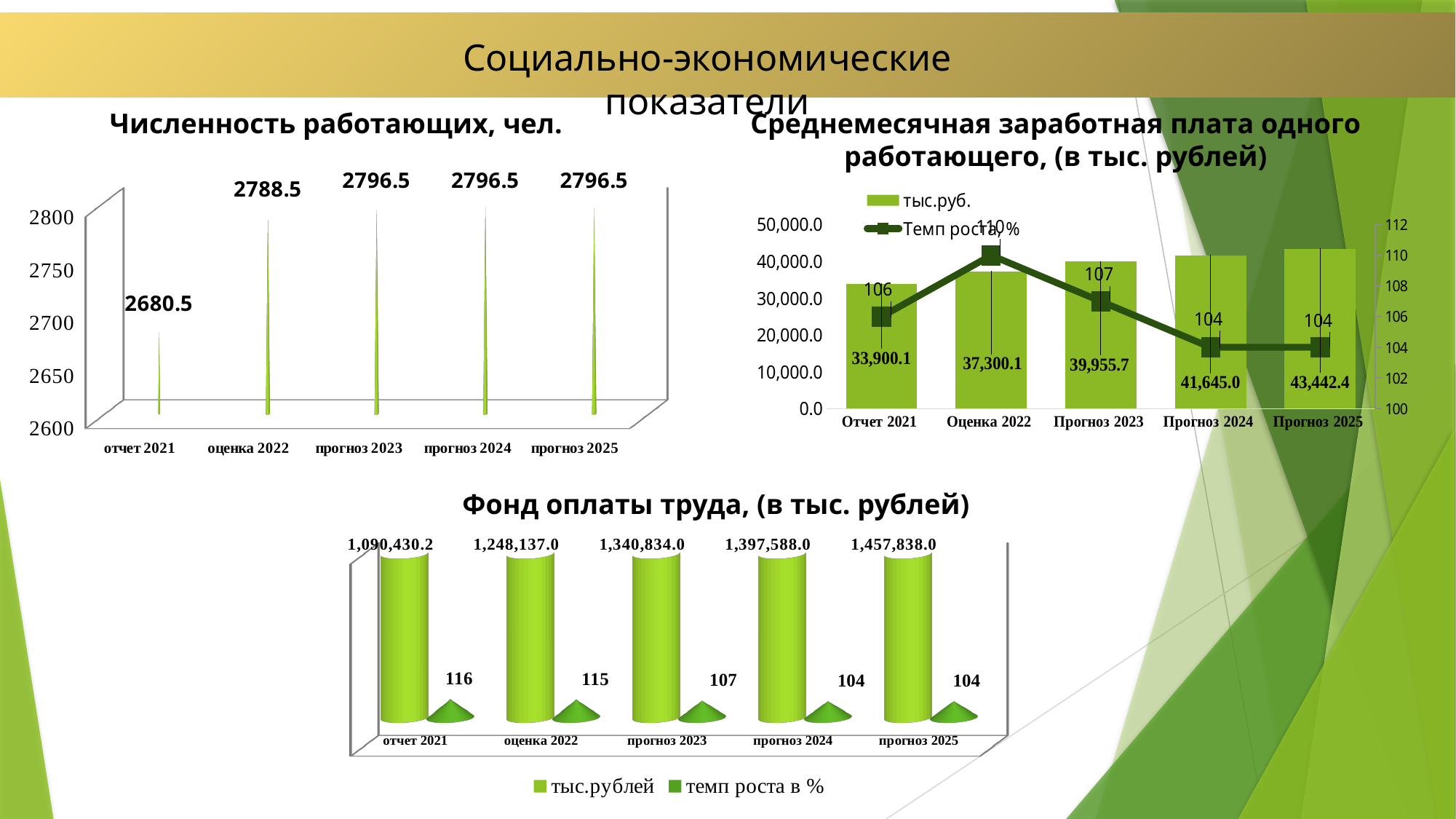
In the chart 'Фонд оплаты труда, (в тыс. рублей)', what is the темп роста в % value for отчет 2021? 116 In the chart 'Среднемесячная заработная плата одного работающего', which category has the highest Темп роста, % value? Оценка 2022 In the chart 'Численность работающих, чел.', what is the value for отчет 2021? 2680.5 In the chart 'Фонд оплаты труда, (в тыс. рублей)', what is the тыс.рублей value for прогноз 2025? 1,457,838.0 In the chart 'Среднемесячная заработная плата одного работающего', do the тыс.руб. bar values rise or fall from Отчет 2021 to Прогноз 2025? rise In the chart 'Численность работающих, чел.', which category has the lowest value? отчет 2021 In the chart 'Численность работающих, чел.', what is the difference between оценка 2022 and отчет 2021? 108 In the chart 'Среднемесячная заработная плата одного работающего', what is the Темп роста, % value for Оценка 2022? 110 In the chart 'Численность работающих, чел.', how many categories are shown on the x axis? 5 In the chart 'Среднемесячная заработная плата одного работающего', how many series does the legend list? 2 In the chart 'Фонд оплаты труда, (в тыс. рублей)', which is larger, the тыс.рублей value for оценка 2022 or for прогноз 2023? прогноз 2023 In the chart 'Среднемесячная заработная плата одного работающего', what is the тыс.руб. value for Прогноз 2023? 39,955.7